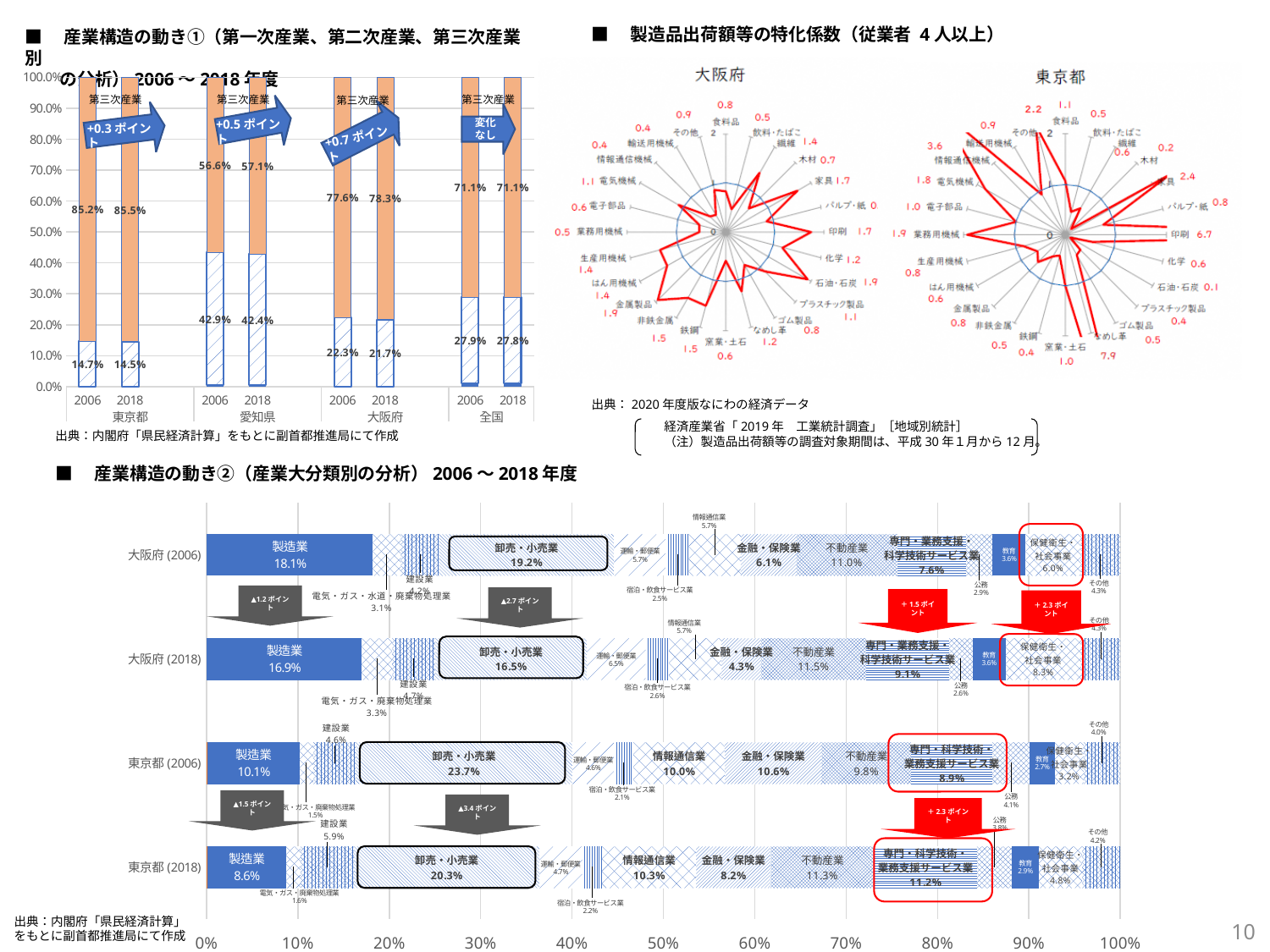
In the top-left chart (産業構造の動き①), how many prefectures/regions are shown on the x axis? 4 In the top-left chart (産業構造の動き①), what is the difference between the 第三次産業 share of 大阪府 in 2018 and in 2006? 0.7% In the top-left chart (産業構造の動き①), which prefecture has the lowest 第三次産業 share in 2018? 愛知県 In the bottom chart (産業構造の動き②), what is the difference in the 保健衛生・社会事業 share for 大阪府 between 2006 and 2018? 2.3% In the bottom chart (産業構造の動き②), how many bars (rows) are shown? 4 In the bottom chart (産業構造の動き②), what is the 製造業 share for 大阪府 (2018)? 16.9% In the top-right radar chart for 東京都, what is the value for 印刷? 6.7 In the top-left chart (産業構造の動き①), what is the 第二次産業 share for 愛知県 in 2006? 42.9% In the top-left chart (産業構造の動き①), what type of chart is used? Stacked bar chart In the bottom chart (産業構造の動き②), what is the 卸売・小売業 share for 東京都 (2006)? 23.7% In the top-left chart (産業構造の動き①), what is the 第三次産業 share for 東京都 in 2018? 85.5% In the bottom chart (産業構造の動き②), which is larger for 東京都 (2018): 金融・保険業 or 不動産業? 不動産業